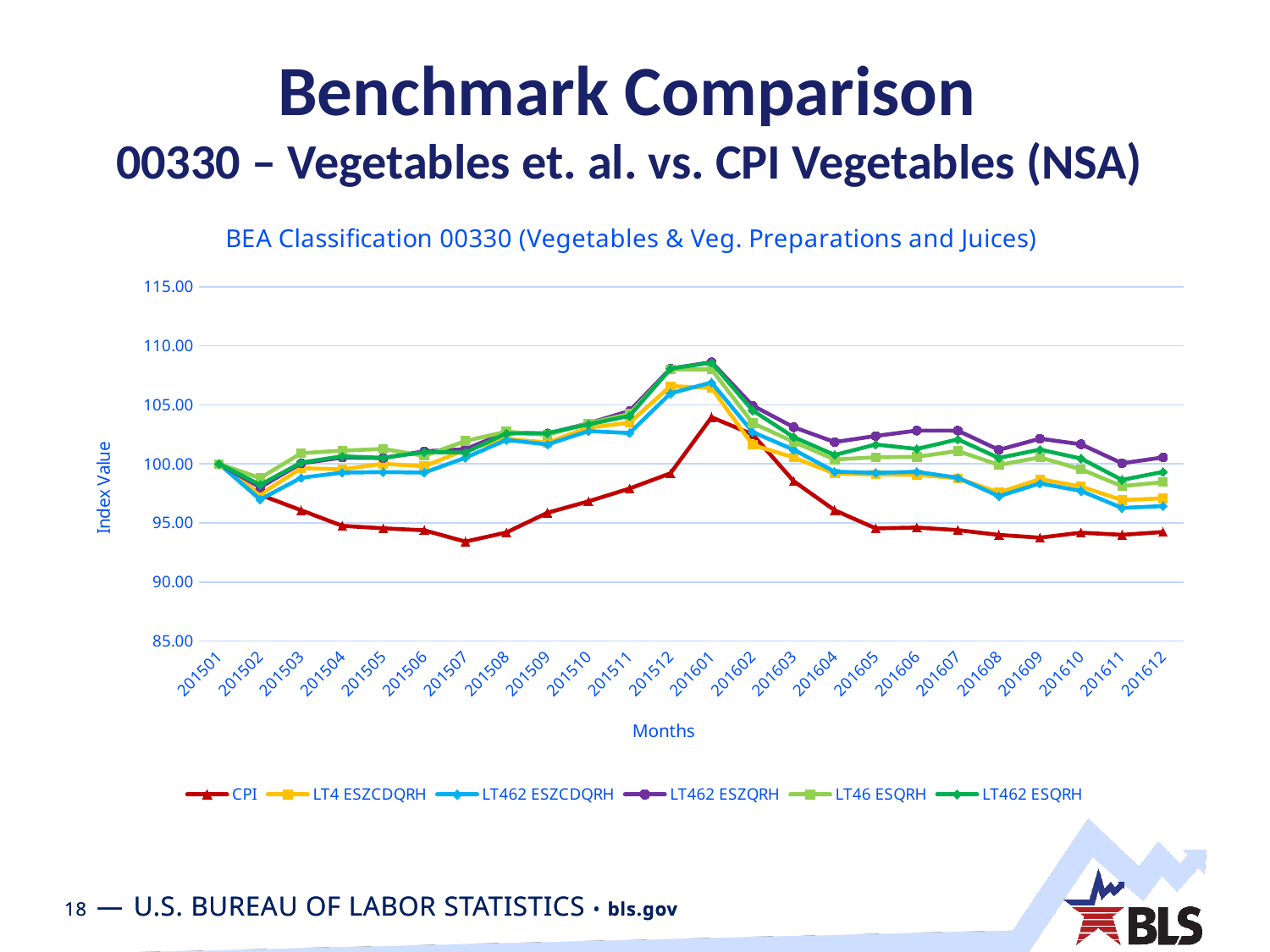
Is the value for CPI at 201507 greater or less than 95.00? less What is the title of the chart? BEA Classification 00330 (Vegetables & Veg. Preparations and Juices) What kind of chart is shown on the slide? line chart How many series does the legend list? 6 What is the value of the CPI series at 201501? 100.00 Is the value for LT462 ESZQRH at 201601 greater or less than 105.00? greater Does the CPI series rise or fall from 201601 to 201604? fall Is the value for CPI at 201601 greater or less than 100.00? greater In which month does the CPI series reach its highest value? 201601 At 201612, which is larger: CPI or LT462 ESZQRH? LT462 ESZQRH How many months are plotted along the x axis? 24